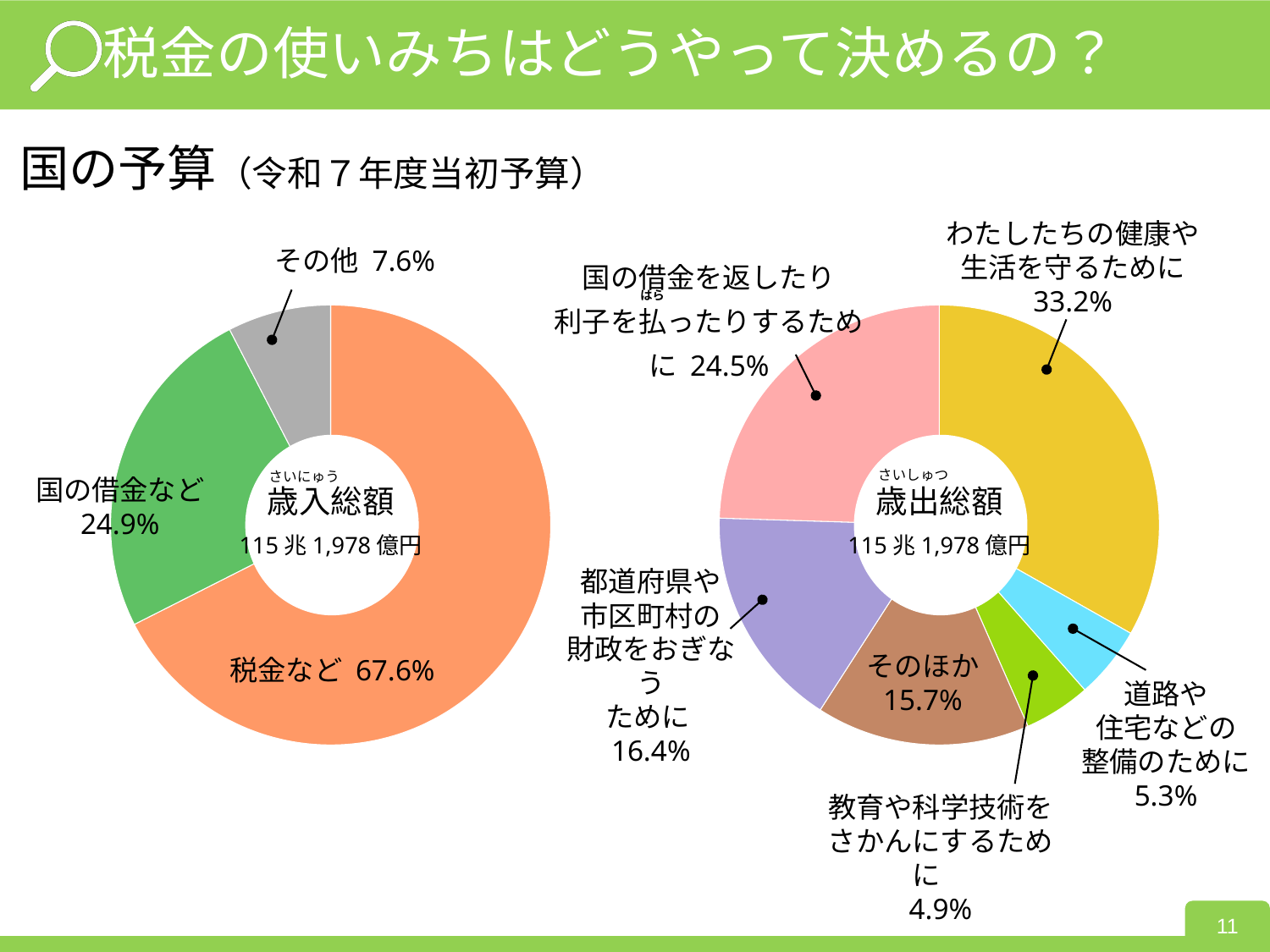
How many categories does the 歳出総額 chart on the right show? 6 In the 歳出総額 chart on the right, which is larger: そのほか or 道路や住宅などの整備のために? そのほか In the 歳入総額 chart on the left, which category has the smallest share? その他 In the 歳出総額 chart on the right, what is the difference in percentage points between 国の借金を返したり利子を払ったりするために and 都道府県や市区町村の財政をおぎなうために? 8.1 What kind of chart is the 歳入総額 chart on the left? Donut (pie) chart In the 歳出総額 chart on the right, which category has the smallest share? 教育や科学技術をさかんにするために In the 歳入総額 chart on the left, what share is 税金など? 67.6% In the 歳出総額 chart on the right, what share is わたしたちの健康や生活を守るために? 33.2% In the 歳入総額 chart on the left, what share is 国の借金など? 24.9% In the 歳出総額 chart on the right, which category has the largest share? わたしたちの健康や生活を守るために In the 歳出総額 chart on the right, what share is 教育や科学技術をさかんにするために? 4.9% What total amount is printed in the centre of the 歳出総額 chart on the right? 115兆1,978億円